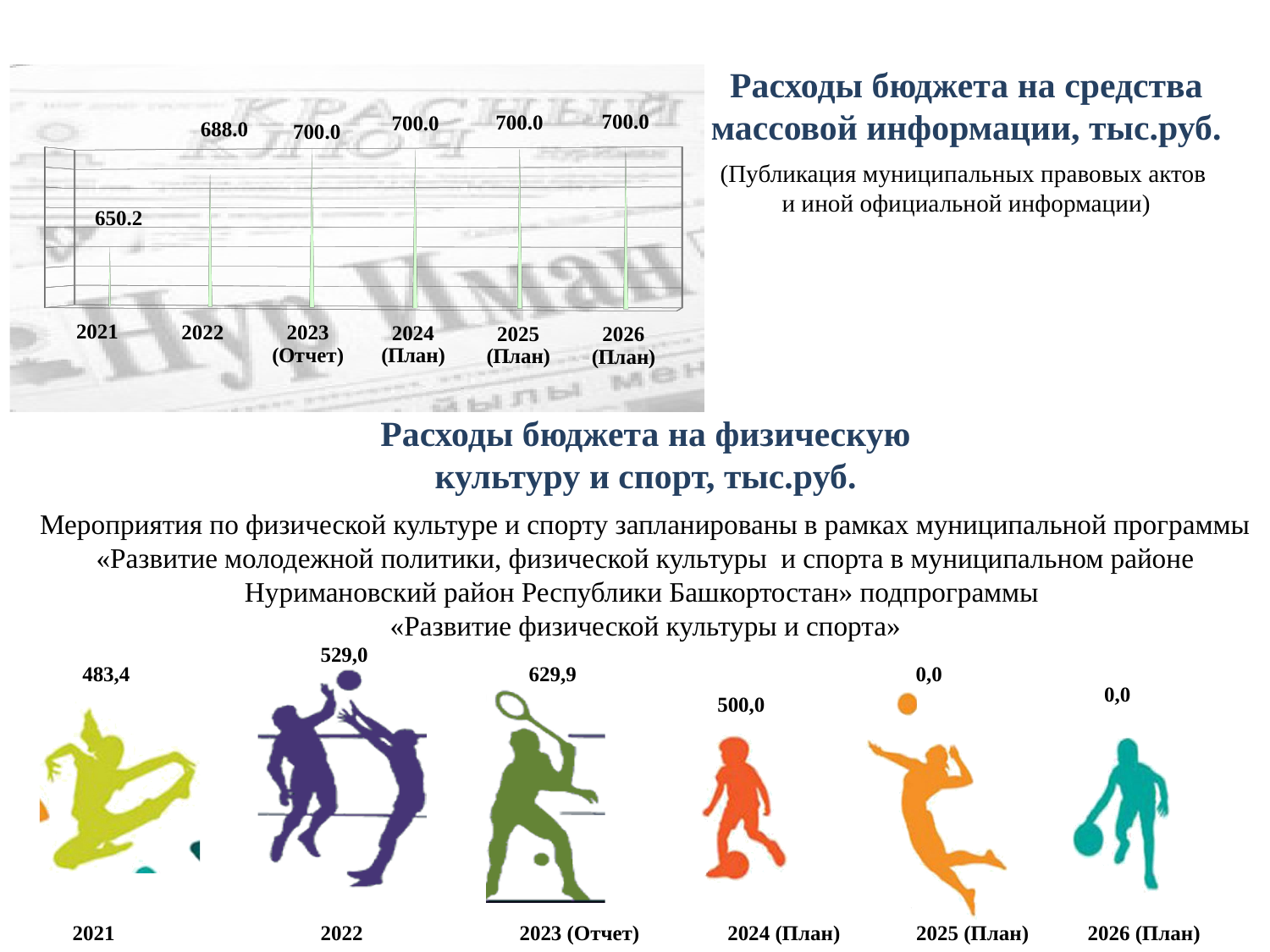
In the chart 'Расходы бюджета на физическую культуру и спорт, тыс.руб.', what is the difference between the values for 2023 (Отчет) and 2021? 146,5 In the chart 'Расходы бюджета на физическую культуру и спорт, тыс.руб.', what is the value for 2023 (Отчет)? 629,9 In the chart 'Расходы бюджета на средства массовой информации, тыс.руб.', which year has the lowest value? 2021 How many years are shown in the chart 'Расходы бюджета на средства массовой информации, тыс.руб.'? 6 In the chart 'Расходы бюджета на средства массовой информации, тыс.руб.', what is the value for 2021? 650.2 In the chart 'Расходы бюджета на физическую культуру и спорт, тыс.руб.', which year has the highest value? 2023 (Отчет) In the chart 'Расходы бюджета на физическую культуру и спорт, тыс.руб.', what is the value for 2025 (План)? 0,0 In the chart 'Расходы бюджета на средства массовой информации, тыс.руб.', what is the difference between the values for 2022 and 2021? 37.8 In the chart 'Расходы бюджета на физическую культуру и спорт, тыс.руб.', which is larger: the value for 2022 or the value for 2024 (План)? 2022 Do the values in the chart 'Расходы бюджета на средства массовой информации, тыс.руб.' rise or fall from 2021 to 2023? rise In the chart 'Расходы бюджета на средства массовой информации, тыс.руб.', what is the value for 2024 (План)? 700.0 In the chart 'Расходы бюджета на средства массовой информации, тыс.руб.', what is the value for 2022? 688.0